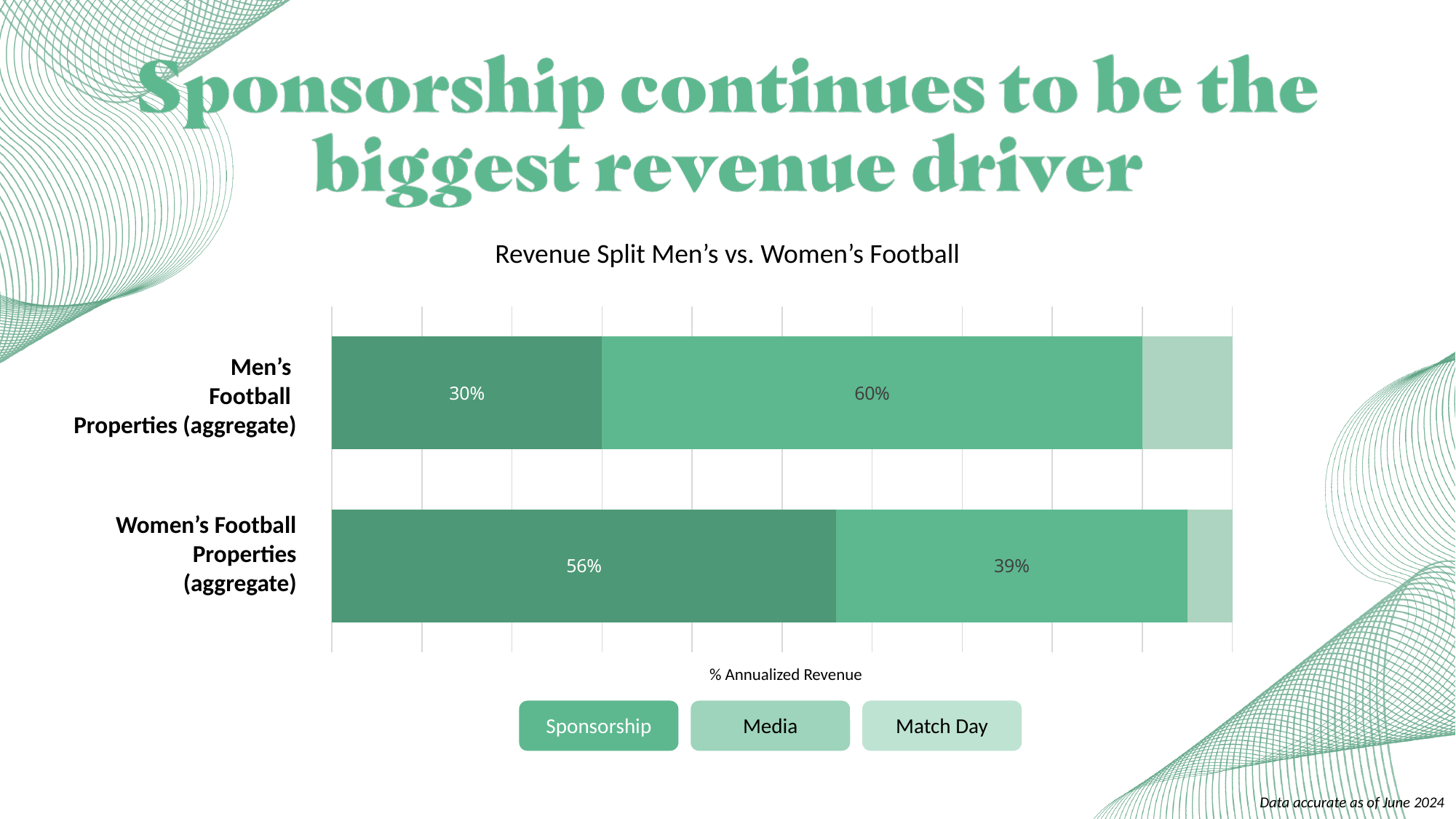
How many categories are plotted in the chart? 2 Which category has the lower Media share? Women's Football Properties (aggregate) What is the Media share for Women's Football Properties (aggregate)? 39% Which category has the higher Sponsorship share? Women's Football Properties (aggregate) What is the title of the chart? Revenue Split Men's vs. Women's Football What is the Sponsorship share for Men's Football Properties (aggregate)? 30% Is the Media share larger for Men's Football Properties or Women's Football Properties? Men's Football Properties (aggregate) How many series does the legend list? 3 What is the Sponsorship share for Women's Football Properties (aggregate)? 56% What is the difference between the Sponsorship shares of Women's and Men's Football Properties? 26% What is the Media share for Men's Football Properties (aggregate)? 60% What type of chart is shown on the slide? Stacked bar chart